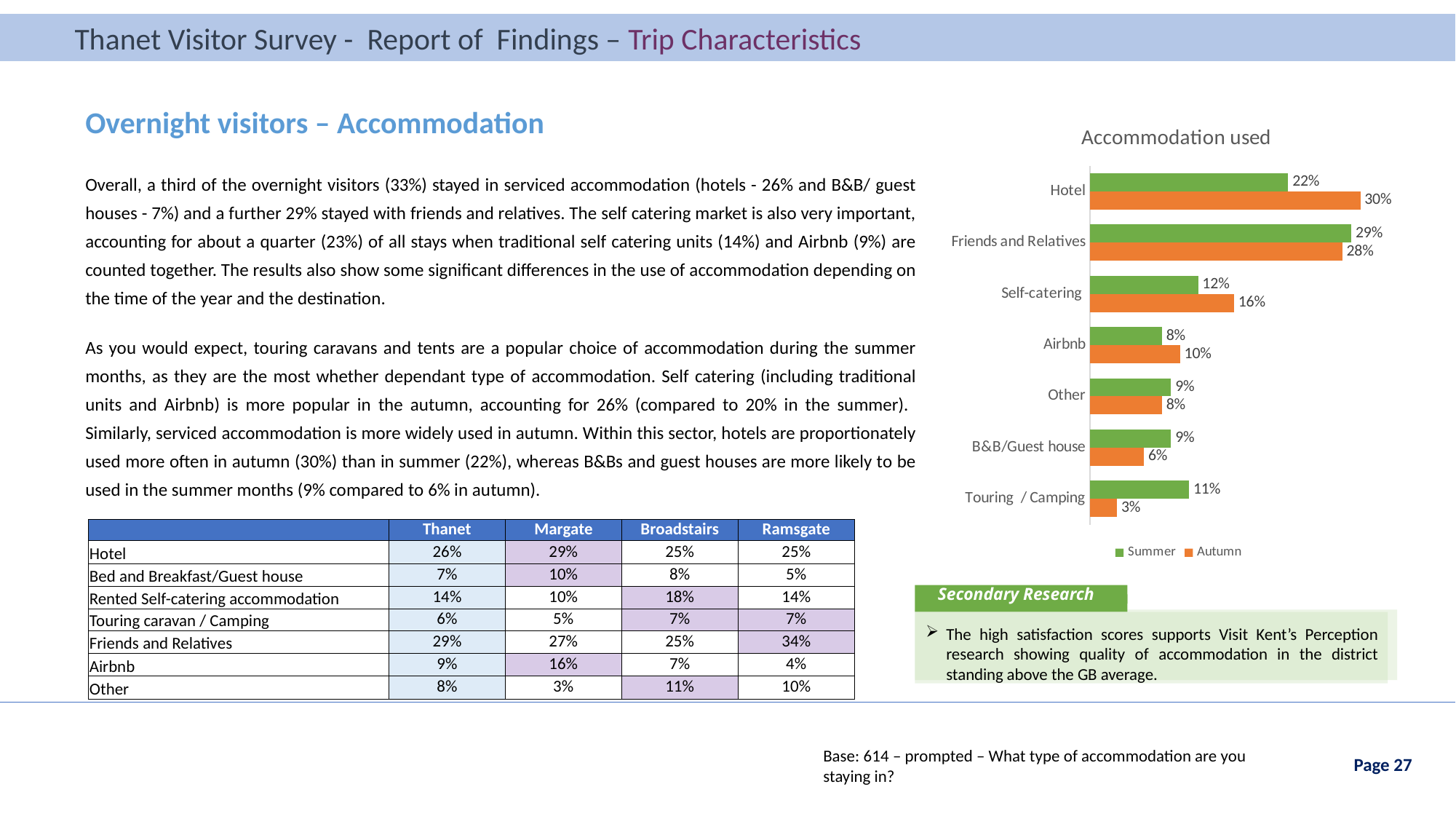
In the Accommodation used chart, is the Summer or Autumn value larger for B&B/Guest house? Summer What type of chart is the Accommodation used chart? Bar chart How many series does the legend of the Accommodation used chart list? 2 Which category has the lowest Autumn value in the Accommodation used chart? Touring / Camping What is the Autumn value for Self-catering in the Accommodation used chart? 16% What is the difference between the Autumn and Summer values for Hotel in the Accommodation used chart? 8% What is the Autumn value for Hotel in the Accommodation used chart? 30% Which colour represents Autumn in the Accommodation used chart? Orange Which category has the highest Autumn value in the Accommodation used chart? Hotel What is the Summer value for Friends and Relatives in the Accommodation used chart? 29% What is the Summer value for Touring / Camping in the Accommodation used chart? 11% How many accommodation categories are shown in the Accommodation used chart? 7